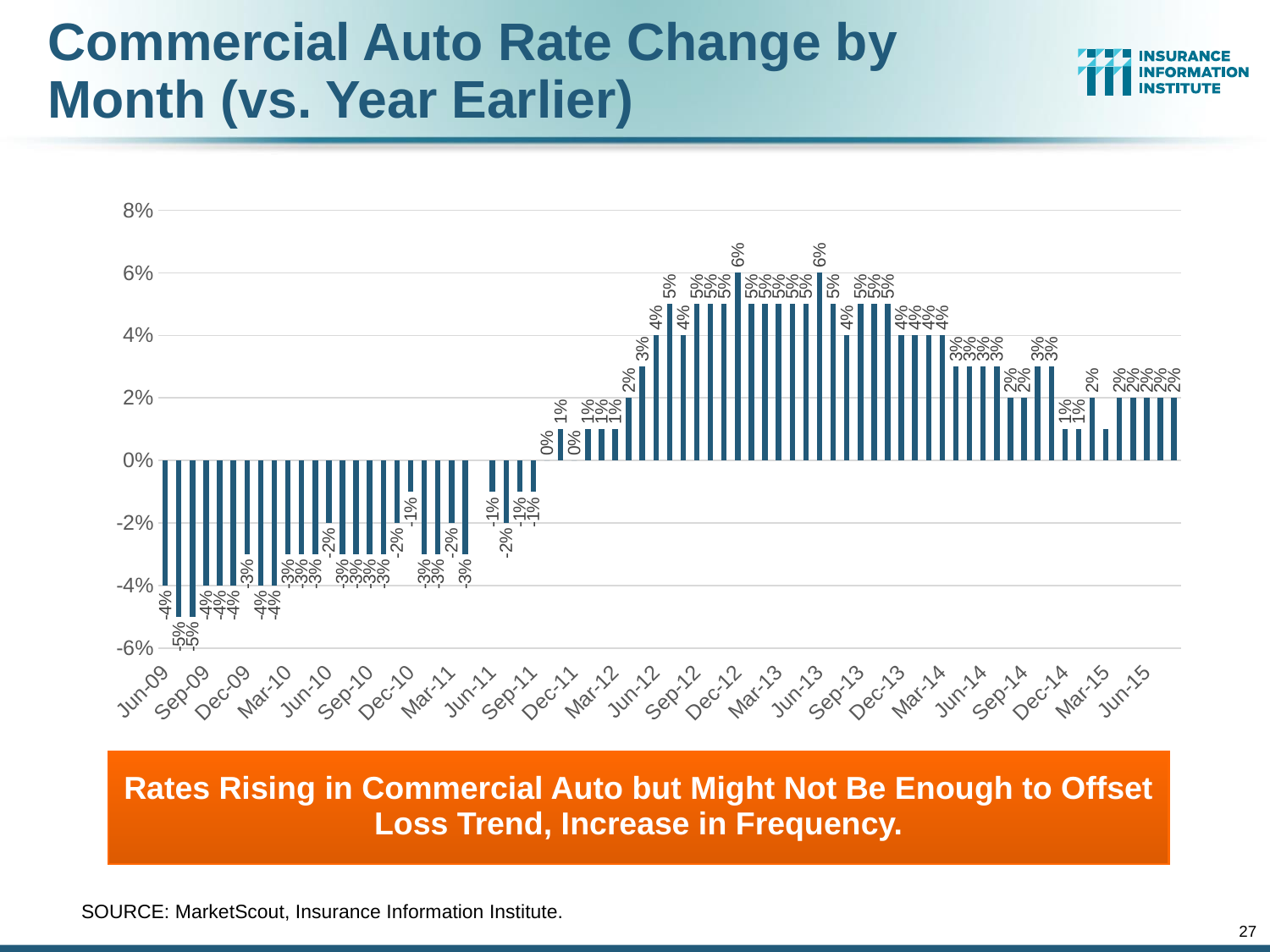
What is the title of the chart on the slide? Commercial Auto Rate Change by Month (vs. Year Earlier) What is the difference between the highest value (6%) and the lowest value (-5%) on the chart? 11 percentage points What source is cited for the chart data? MarketScout, Insurance Information Institute What is the highest rate change value shown on the chart? 6% What is the rate change for Jun-15, the last bar on the chart? 2% Do the rate changes generally rise or fall from Jun-09 to Jun-15? Rise Is the rate change for Sep-09 greater or less than -2%? less What is the rate change for Jun-09, the first bar on the chart? -4% What kind of chart is shown on the slide? Bar chart Which is larger, the rate change for Jun-09 or for Jun-15? Jun-15 Is the rate change for Jun-13 greater or less than 4%? greater What is the lowest rate change value shown on the chart? -5%